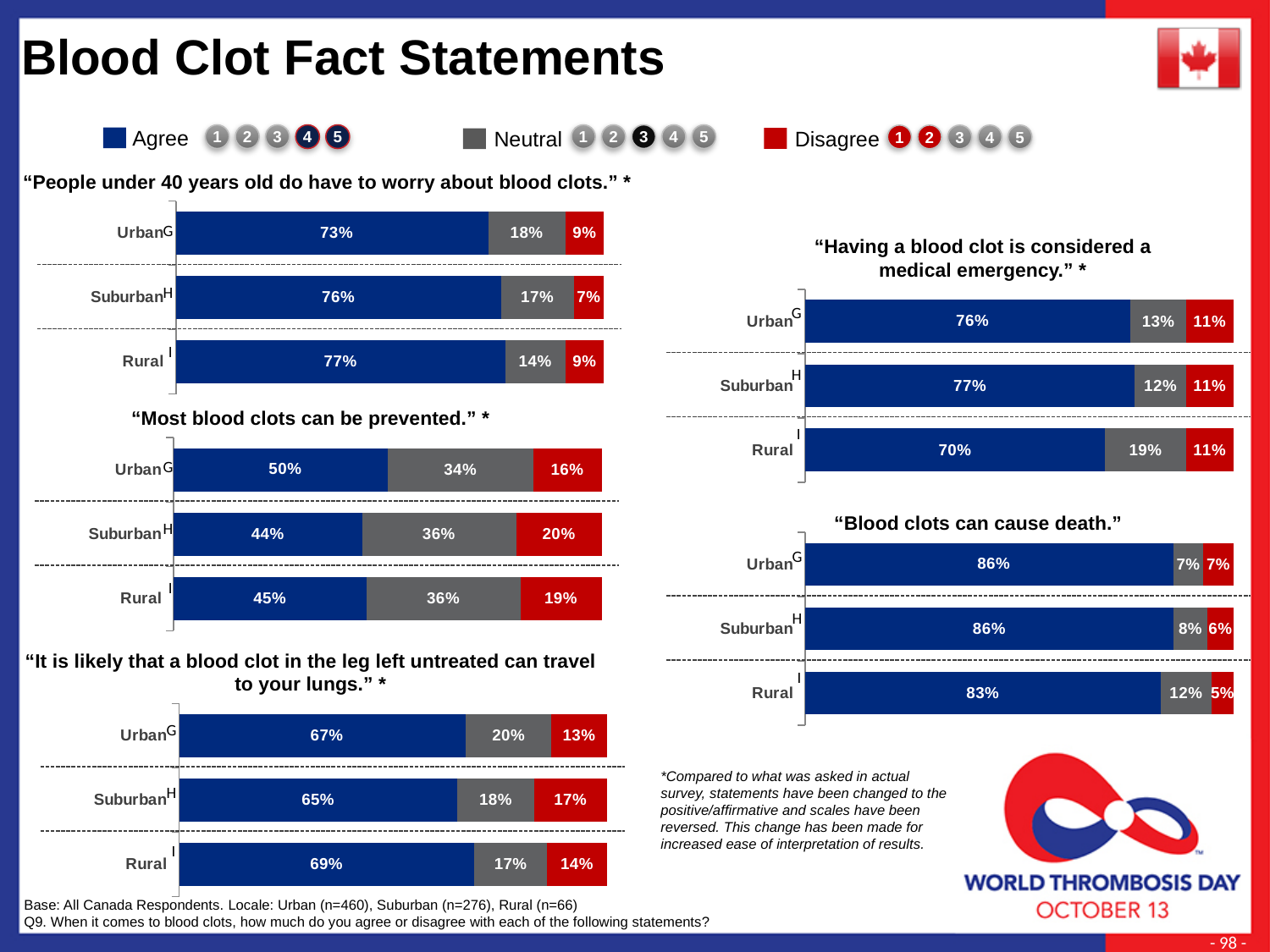
In the chart "Most blood clots can be prevented.", which locale has the lowest Agree percentage? Suburban According to the legend, what colour represents Disagree? Red In the chart "People under 40 years old do have to worry about blood clots.", what percentage of Rural respondents agree? 77% In the chart "Having a blood clot is considered a medical emergency.", which locale has the highest Agree percentage? Suburban In the chart "Blood clots can cause death.", what is the difference between the Agree percentage for Urban and for Rural? 3 percentage points In the chart "Most blood clots can be prevented.", what is the Neutral value for Urban respondents? 34% In the chart "Having a blood clot is considered a medical emergency.", what is the Neutral value for Rural respondents? 19% In the chart "Blood clots can cause death.", how many locale categories are shown? 3 In the chart "It is likely that a blood clot in the leg left untreated can travel to your lungs.", which has the larger Disagree percentage, Suburban or Rural? Suburban In the chart "Most blood clots can be prevented.", what is the total of the Suburban bar (Agree + Neutral + Disagree)? 100% What kind of chart is used for "People under 40 years old do have to worry about blood clots."? Stacked horizontal bar chart How many series does the legend at the top of the slide list? 3